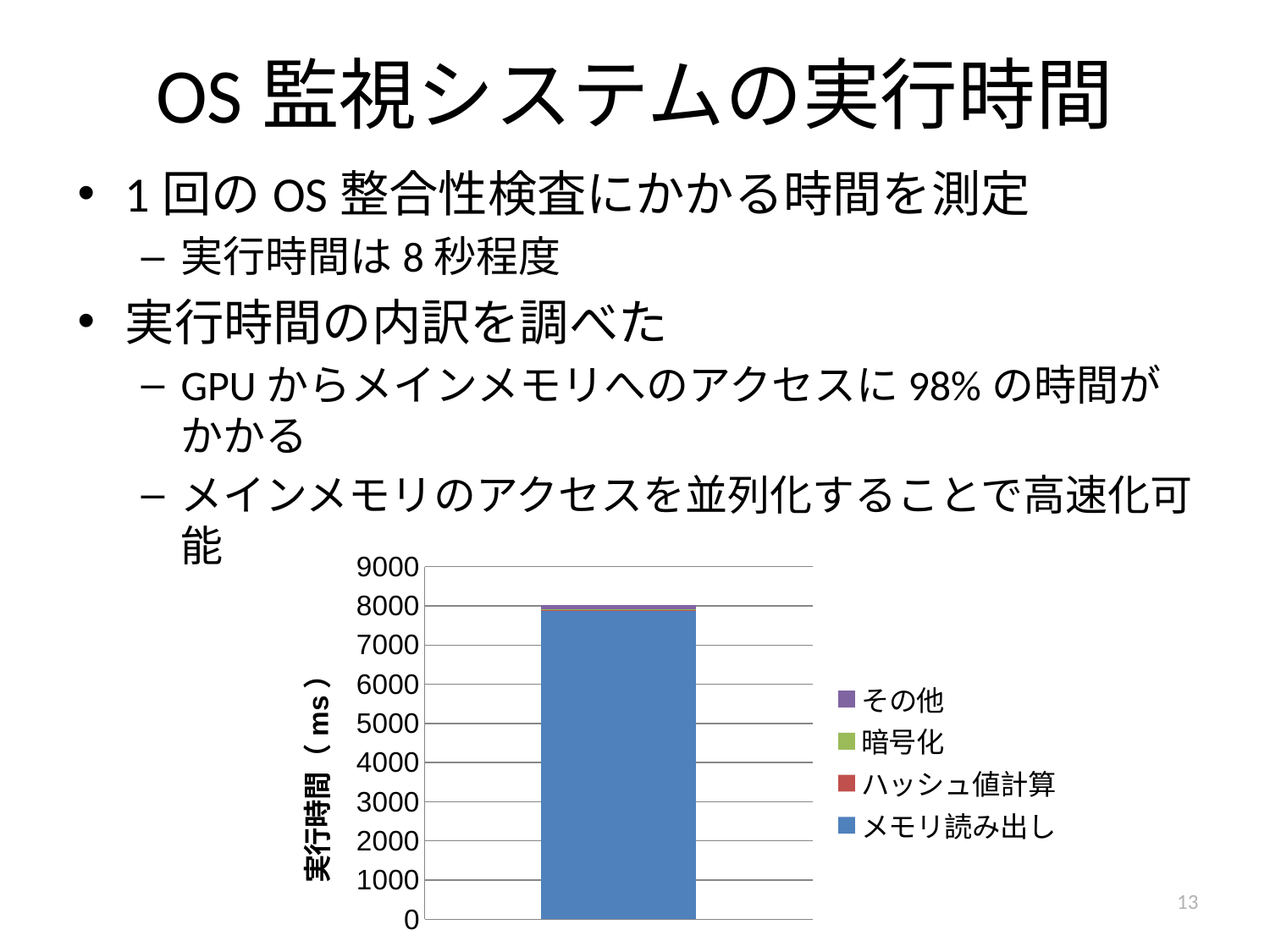
Is the value for ハッシュ値計算 greater or less than 1000? less How many bars are plotted in the chart? 1 What is the label of the vertical axis of the chart? 実行時間（ms） Is the total height of the stacked bar greater or less than 7000? greater Which series accounts for the largest part of the stacked bar? メモリ読み出し How many series does the chart legend list? 4 Which series is shown in blue in the chart legend? メモリ読み出し Is the value for メモリ読み出し greater or less than 7000? greater Which is larger, the value for メモリ読み出し or the value for 暗号化? メモリ読み出し What is the highest tick value shown on the vertical axis? 9000 What kind of chart is shown on the slide? stacked bar chart